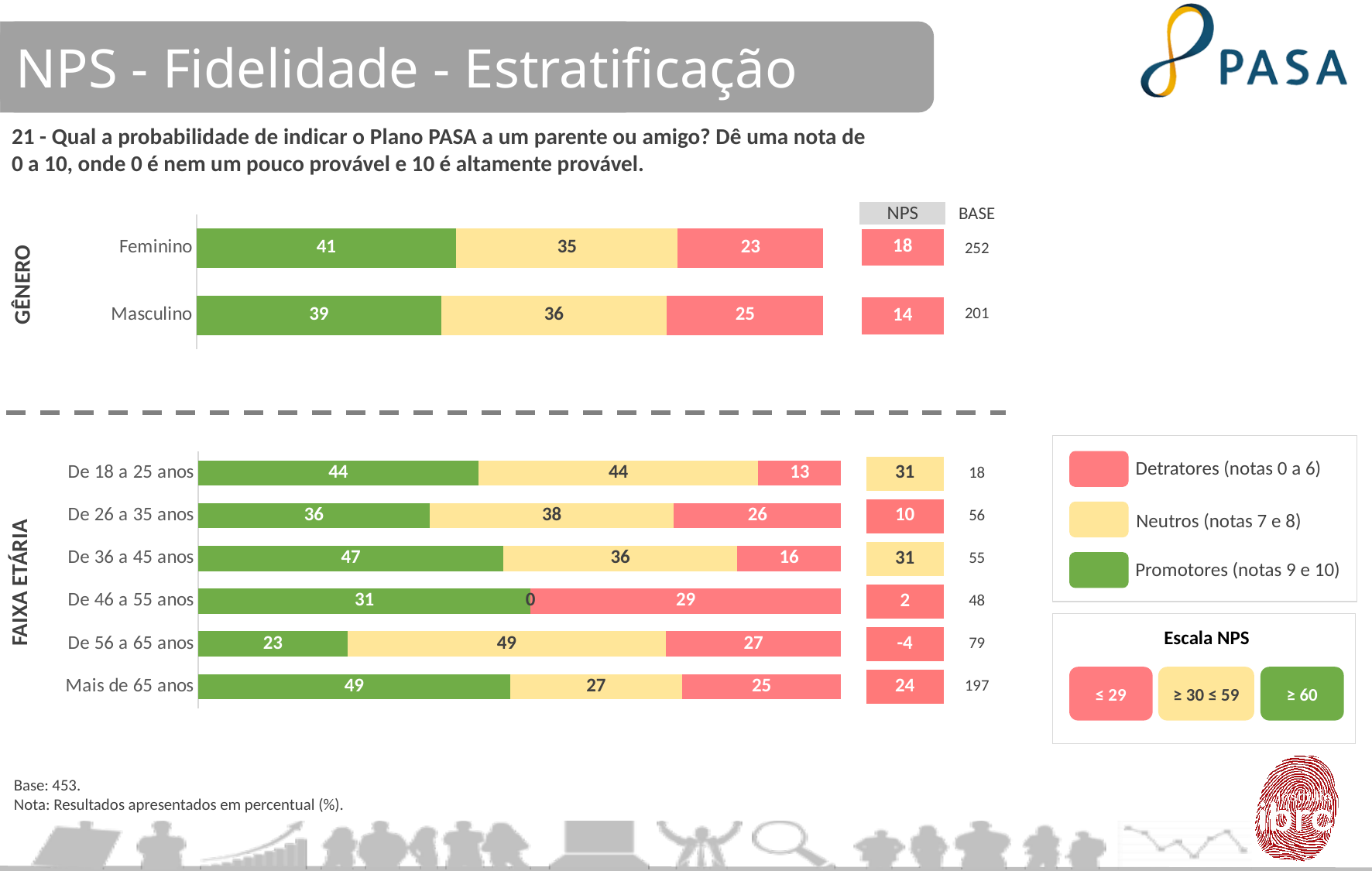
In the FAIXA ETÁRIA chart, which has the larger Promotores value: De 36 a 45 anos or De 26 a 35 anos? De 36 a 45 anos In the GÊNERO chart, what is the difference between the Detratores values for Masculino and Feminino? 2 What kind of chart is used on the slide to show the GÊNERO and FAIXA ETÁRIA results? Stacked bar chart How many series does the legend list? 3 In the GÊNERO chart, what is the total of the three segments in the Feminino bar? 99 In the GÊNERO chart, what is the Neutros value for Masculino? 36 In the FAIXA ETÁRIA chart, which age group has the highest Promotores value? Mais de 65 anos How many age groups are shown in the FAIXA ETÁRIA chart? 6 In the FAIXA ETÁRIA chart, which age group has the lowest NPS? De 56 a 65 anos In the FAIXA ETÁRIA chart, what is the NPS for De 56 a 65 anos? -4 In the FAIXA ETÁRIA chart, what is the BASE value for Mais de 65 anos? 197 In the GÊNERO chart, what is the Promotores value for Feminino? 41